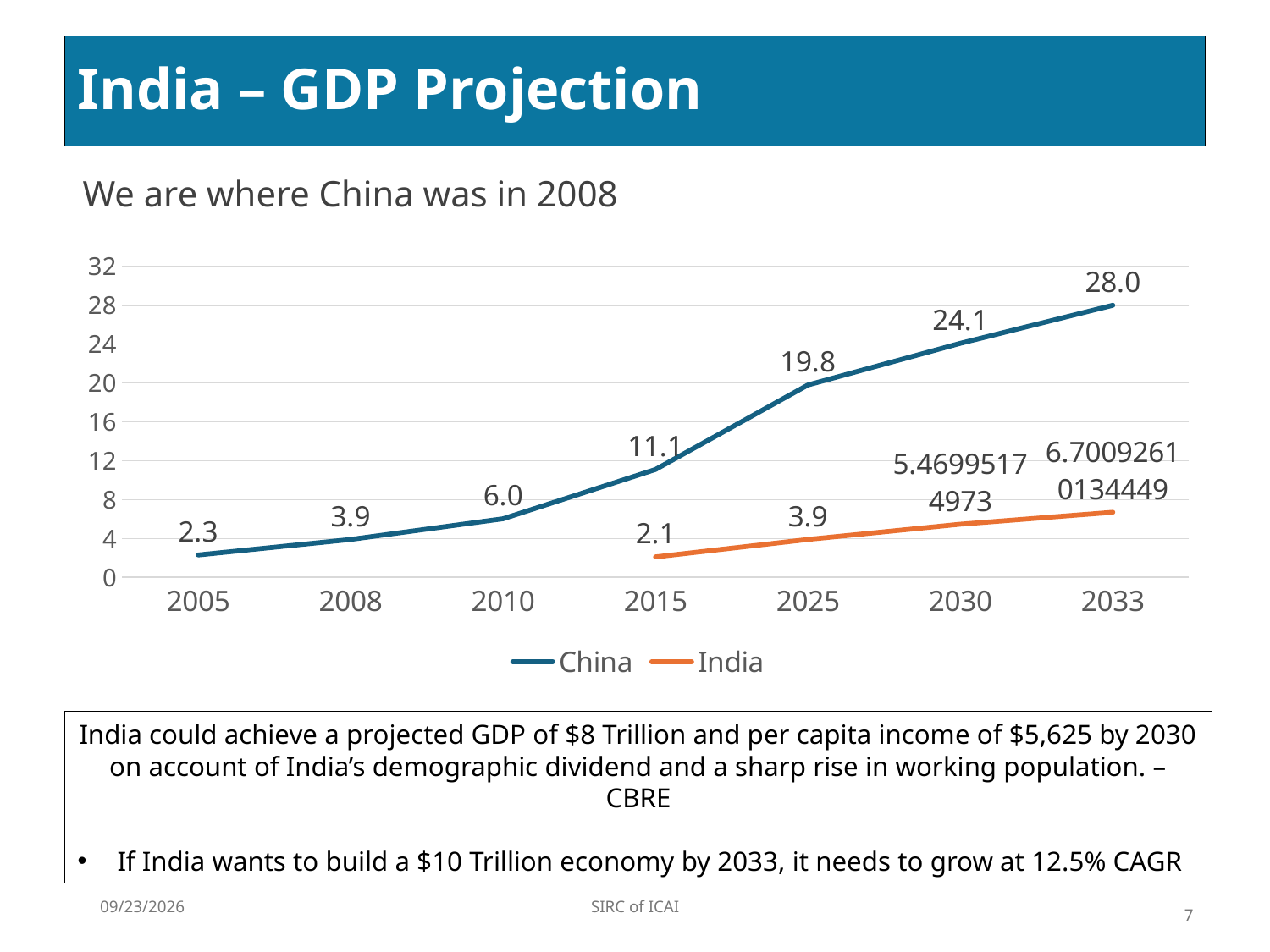
Is the value for China in 2030 greater or less than 20? greater What is the value for China in 2015? 11.1 What is the value for India in 2015? 2.1 What is the value for India in 2025? 3.9 In which year does the China series reach its highest value? 2033 How many years are shown on the x axis? 7 In which year does the China series have its lowest value? 2005 What kind of chart is shown on the slide? Line chart How many series does the legend list? 2 Which is larger: China's value in 2025 or India's value in 2025? China's value in 2025 What is the value for China in 2033? 28.0 What is the difference between China's value in 2033 and its value in 2030? 3.9